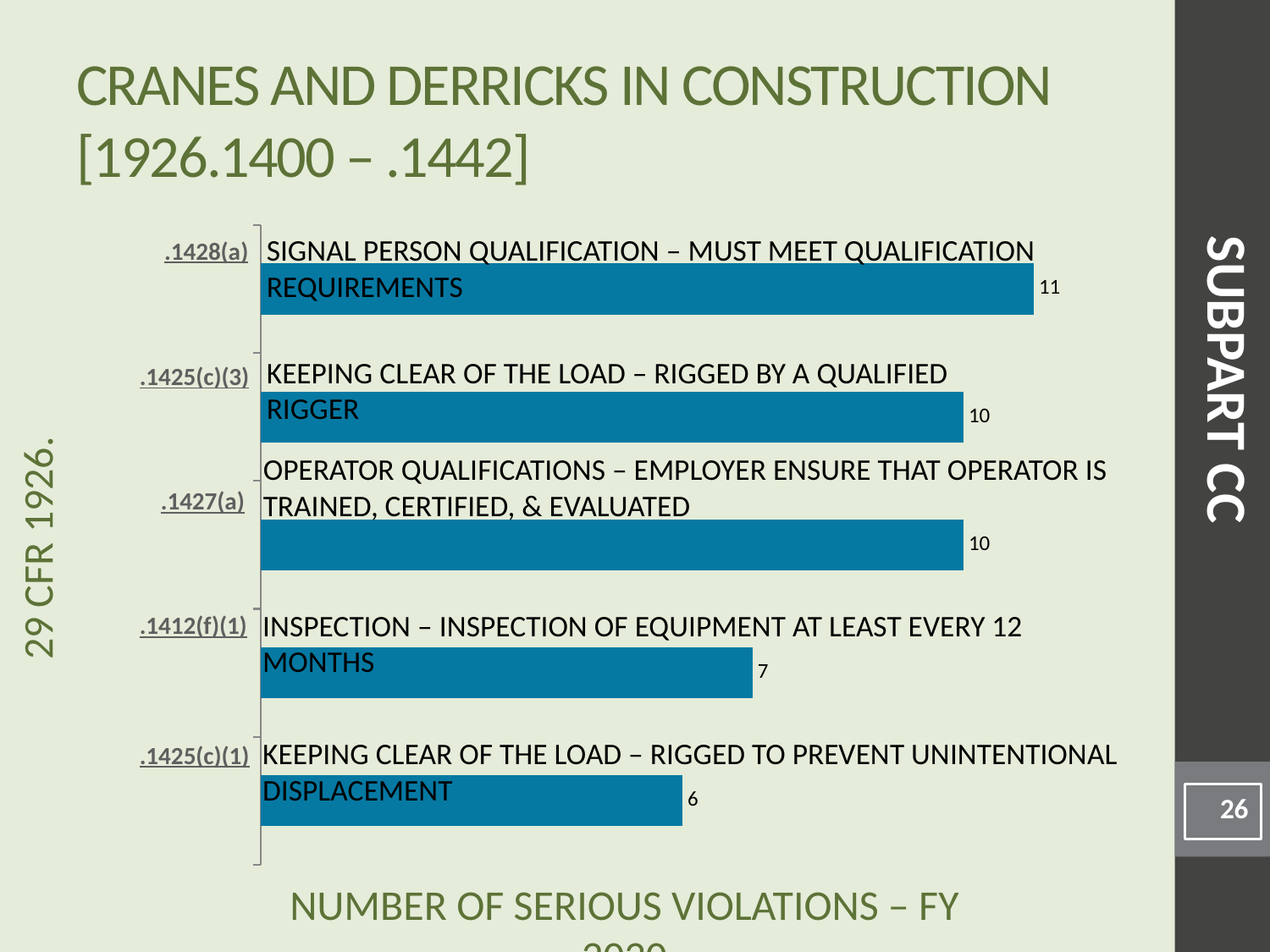
What is the title of the chart? NUMBER OF SERIOUS VIOLATIONS – FY 2020 Which has more serious violations, .1412(f)(1) or .1425(c)(1)? .1412(f)(1) Which standard has the highest number of serious violations? .1428(a) What is the difference between the number of serious violations for .1425(c)(3) and .1412(f)(1)? 3 What is the difference between the number of serious violations for .1428(a) and .1425(c)(1)? 5 How many standards (categories) are shown in the chart? 5 What type of chart is shown on the slide? Bar chart What is the number of serious violations for .1425(c)(1) (Keeping clear of the load – rigged to prevent unintentional displacement)? 6 What is the number of serious violations for .1428(a) (Signal Person Qualification)? 11 Which standard has the lowest number of serious violations? .1425(c)(1) What is the number of serious violations for .1412(f)(1) (Inspection of equipment at least every 12 months)? 7 What is the number of serious violations for .1427(a) (Operator Qualifications)? 10